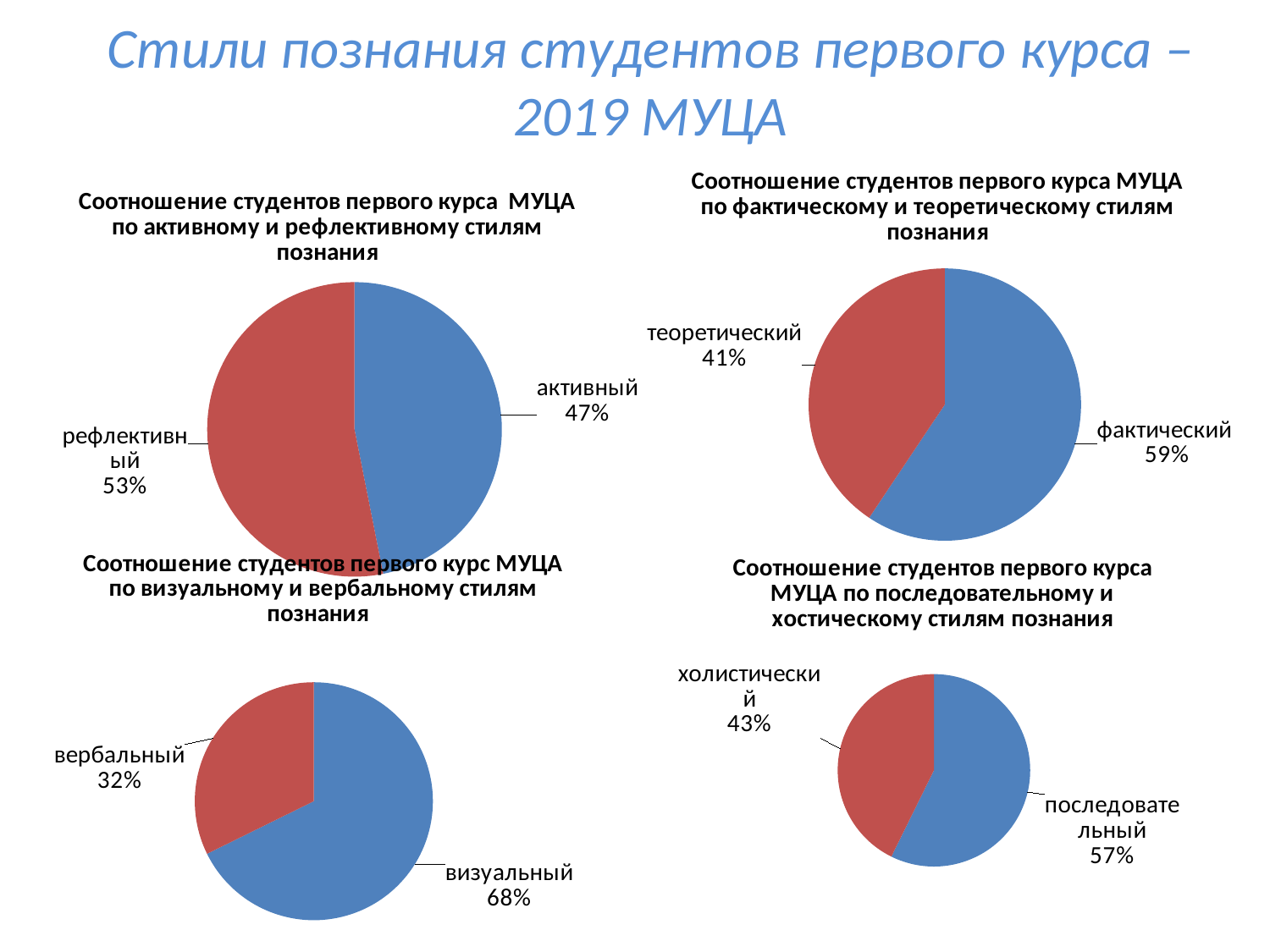
How many charts are shown on the slide? 4 In the bottom-left pie chart (визуальный и вербальный стили), what share is labelled for визуальный? 68% In the bottom-left pie chart (визуальный и вербальный стили), what is the difference in percentage points between визуальный and вербальный? 36 In the bottom-right pie chart (последовательный и холистический стили), what share is labelled for холистический? 43% In the top-left pie chart (активный и рефлективный стили), what share is labelled for рефлективный? 53% How many slices does the bottom-left pie chart (визуальный и вербальный стили) have? 2 In the top-left pie chart (активный и рефлективный стили), what is the difference in percentage points between рефлективный and активный? 6 In the bottom-right pie chart (последовательный и холистический стили), which slice is the largest? последовательный What type of chart is the top-right chart (фактический и теоретический стили)? pie chart In the top-right pie chart (фактический и теоретический стили), what share is labelled for теоретический? 41% In the top-right pie chart (фактический и теоретический стили), which slice is larger, фактический or теоретический? фактический In the top-left pie chart (активный и рефлективный стили), what share is labelled for активный? 47%